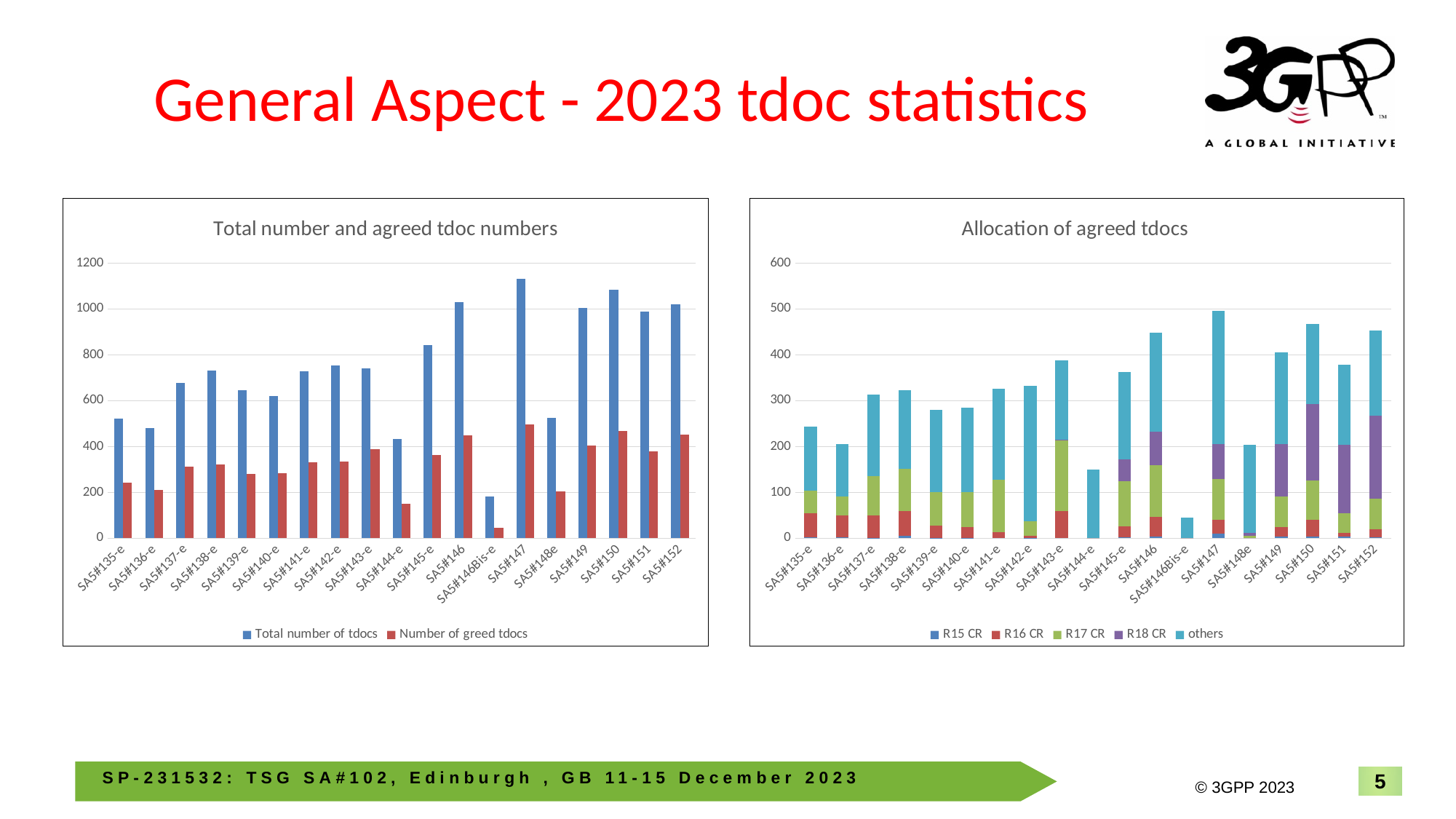
In the 'Total number and agreed tdoc numbers' chart, which meeting has the lowest total number of tdocs? SA5#146Bis-e In the 'Allocation of agreed tdocs' chart, which meeting has the shortest stacked bar? SA5#146Bis-e In the 'Total number and agreed tdoc numbers' chart, is the total number of tdocs for SA5#135-e greater or less than 600? less In the 'Total number and agreed tdoc numbers' chart, how many series does the legend list? 2 In the 'Total number and agreed tdoc numbers' chart, which meeting has the highest total number of tdocs? SA5#147 In the 'Allocation of agreed tdocs' chart, which meeting has the tallest stacked bar? SA5#147 In the 'Allocation of agreed tdocs' chart, how many series does the legend list? 5 In the 'Total number and agreed tdoc numbers' chart, is the total number of tdocs for SA5#147 greater or less than 1000? greater In the 'Total number and agreed tdoc numbers' chart, which has a larger total number of tdocs, SA5#150 or SA5#149? SA5#150 What kind of chart is the 'Total number and agreed tdoc numbers' chart? bar chart In the 'Allocation of agreed tdocs' chart, is the stacked bar for SA5#144-e greater or less than 200? less In the 'Total number and agreed tdoc numbers' chart, how many meetings are shown on the x axis? 19